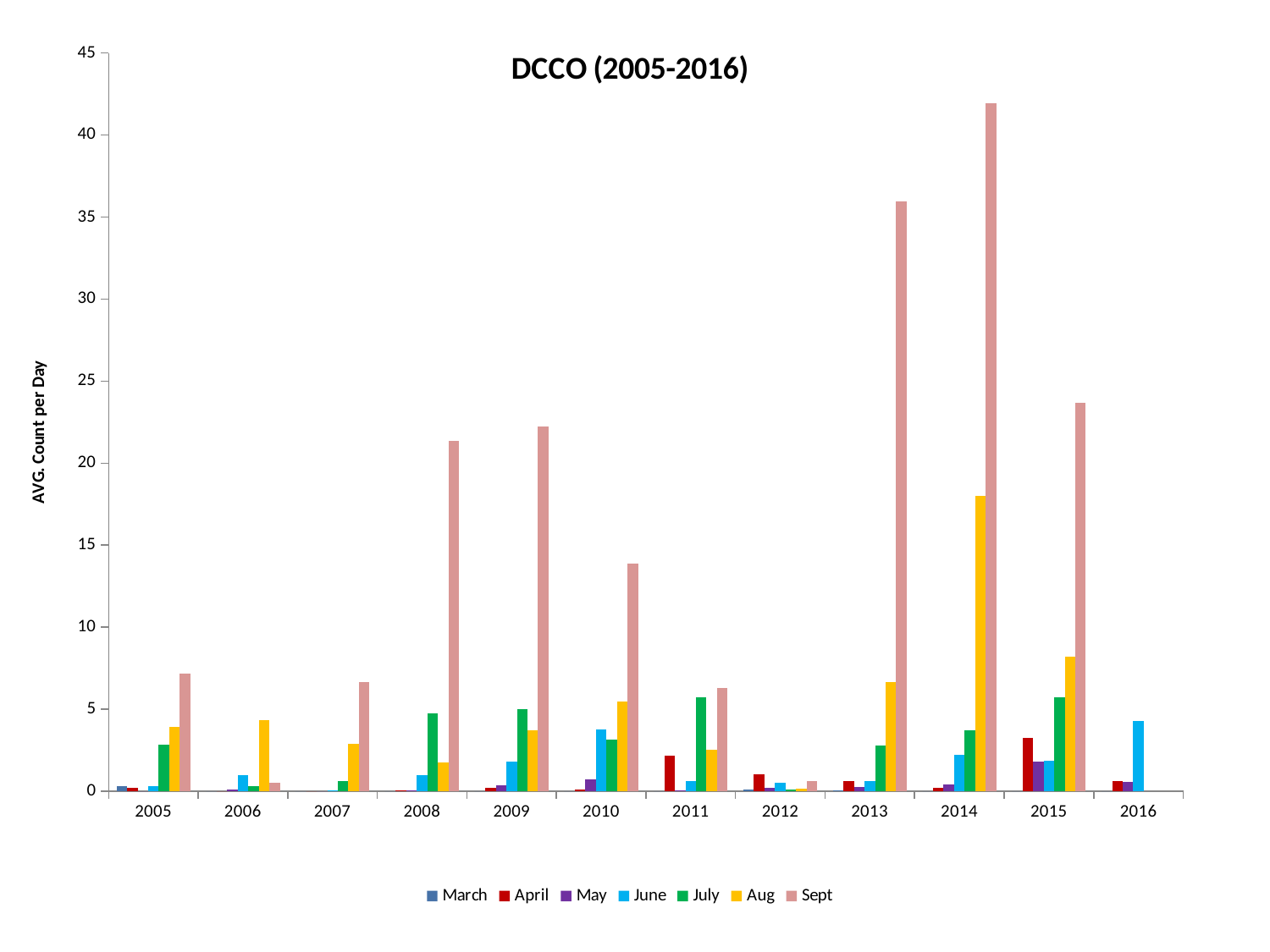
How many series does the legend list? 7 In which year is the Sept value highest? 2014 Is the Sept value for 2015 greater or less than 20? greater Is the Sept value for 2013 greater or less than 35? greater What kind of chart is shown on the slide? bar chart What is the title of the chart? DCCO (2005-2016) Which is larger, the Aug value for 2014 or the Aug value for 2015? 2014 How many years are shown along the x axis? 12 What is the label on the vertical axis? AVG. Count per Day Is the Aug value for 2014 greater or less than 15? greater Which is larger, the Sept value for 2013 or the Sept value for 2015? 2013